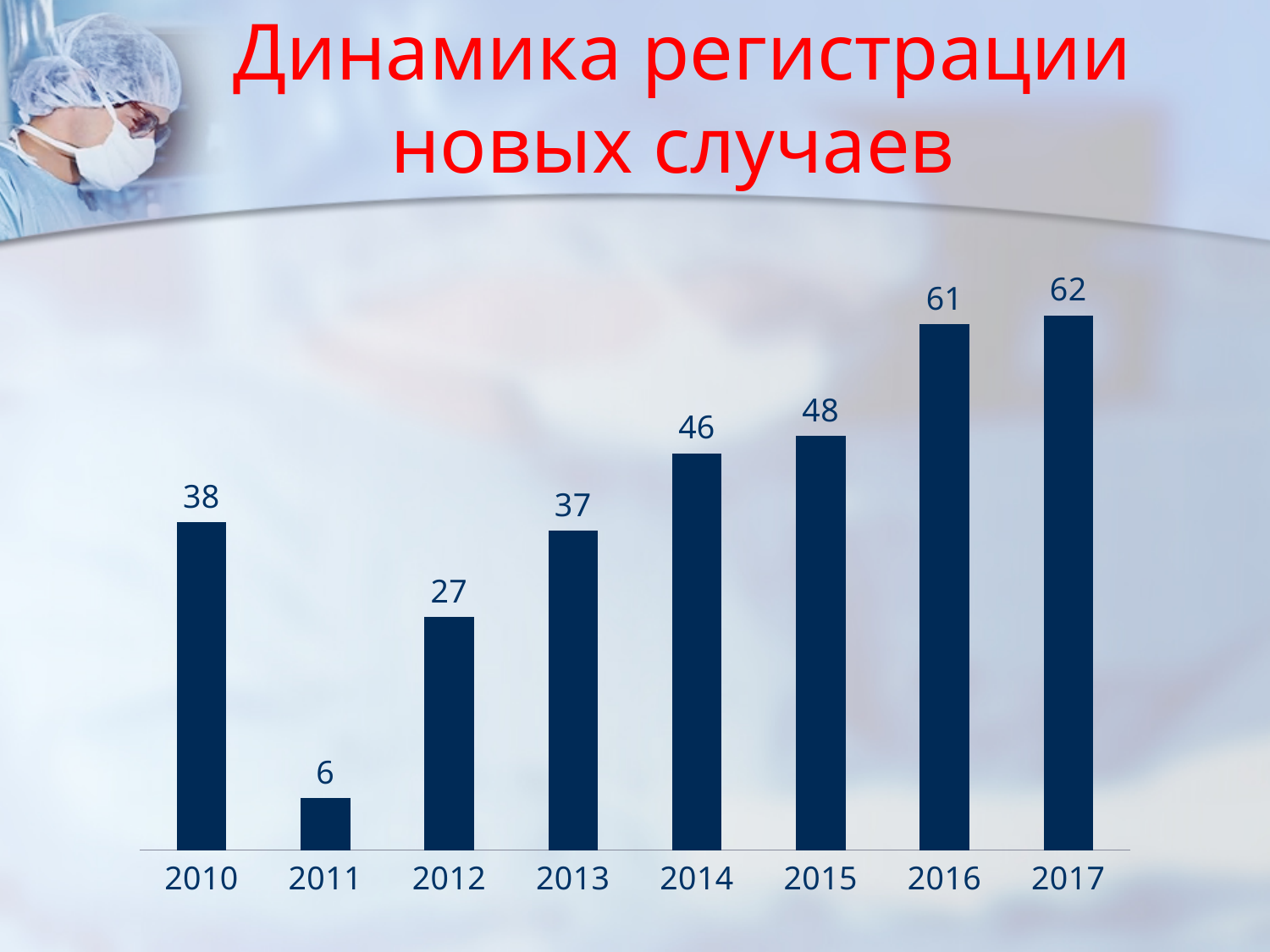
What is the value for 2014? 46 How many years are shown on the x axis? 8 Which is larger, the value for 2013 or the value for 2015? 2015 Do the values rise or fall from 2011 to 2017? Rise Which year has the lowest value? 2011 What is the title of the slide? Динамика регистрации новых случаев What is the value for 2017? 62 What is the value for 2010? 38 What is the difference between the values for 2010 and 2011? 32 What is the difference between the values for 2016 and 2012? 34 Which year has the highest value? 2017 What kind of chart is shown on the slide? Bar chart